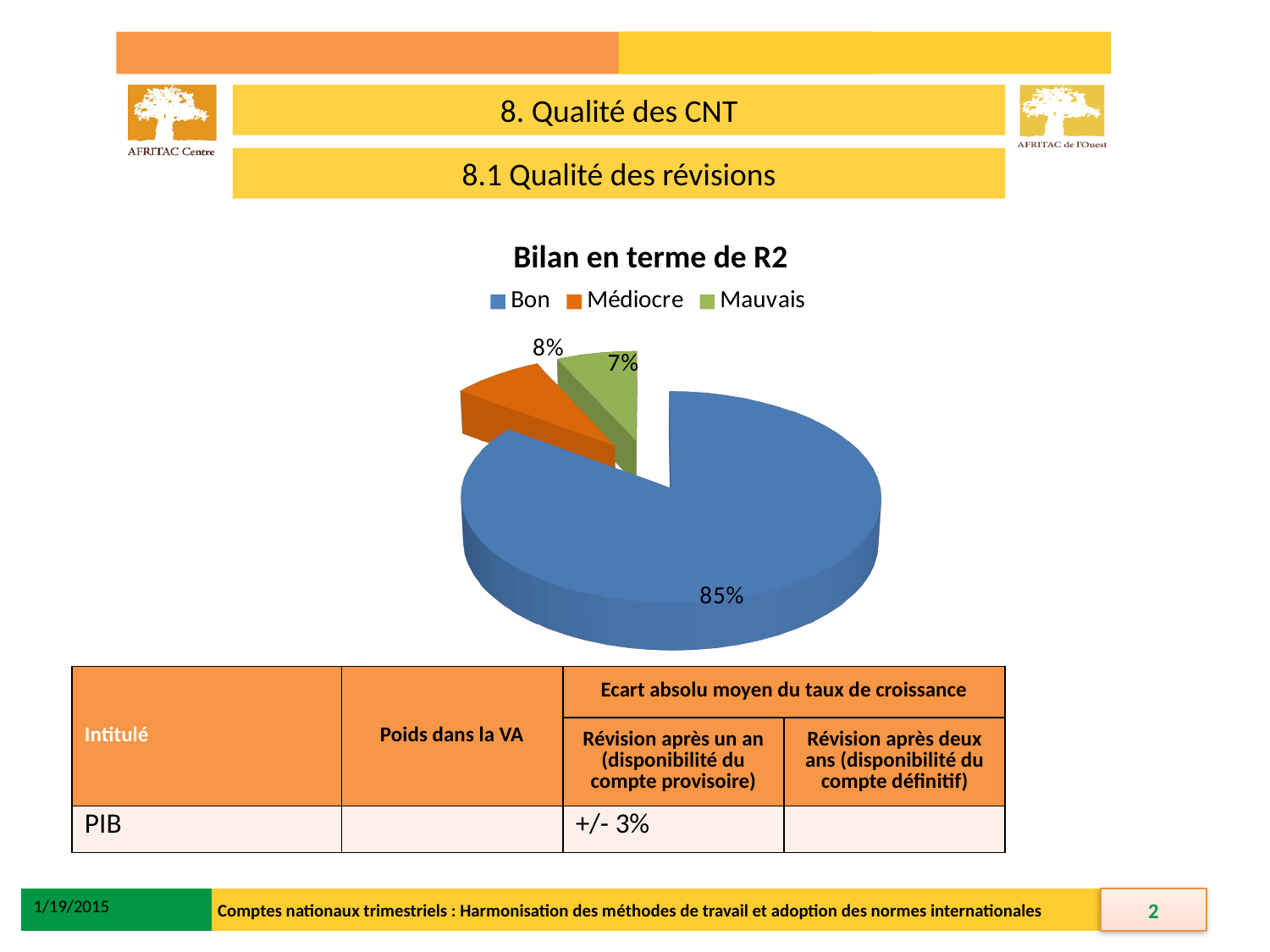
Which is larger, the share for Médiocre or the share for Mauvais? Médiocre What is the difference in percentage points between Bon and Médiocre? 77 What type of chart is shown on the slide? pie chart How many categories does the legend list? 3 What colour is the Bon slice in the pie chart? blue What is the title of the pie chart? Bilan en terme de R2 Which category has the largest slice of the pie? Bon Which category has the smallest slice of the pie? Mauvais What share of the pie does Mauvais represent? 7% What share of the pie does Bon represent? 85% What share of the pie does Médiocre represent? 8% How many slices does the pie chart have? 3